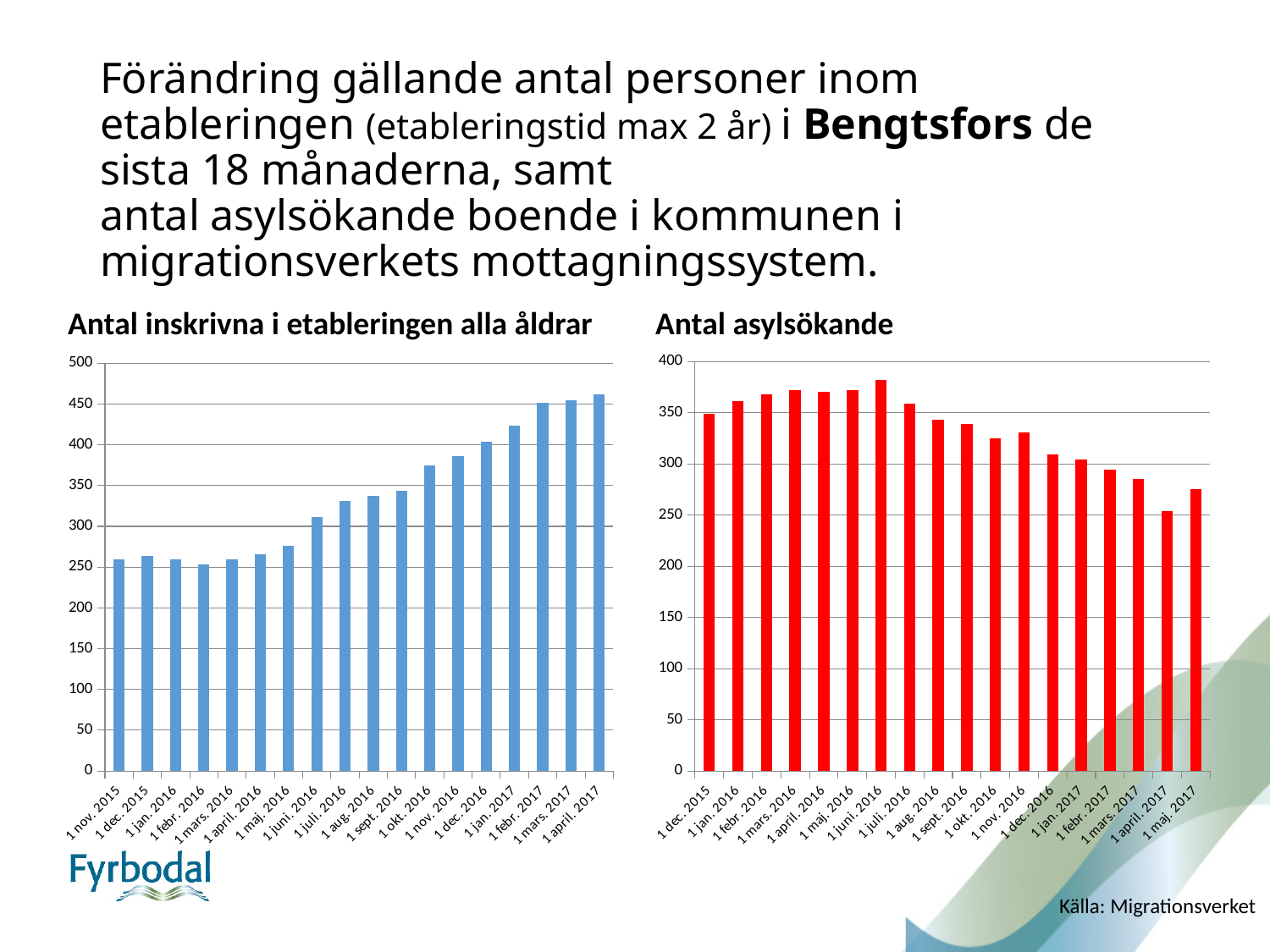
What kind of chart is the 'Antal inskrivna i etableringen alla åldrar' chart? bar chart In the 'Antal asylsökande' chart, do the values generally rise or fall from 1 juni. 2016 to 1 april. 2017? fall What colour are the bars in the 'Antal asylsökande' chart? red In the 'Antal asylsökande' chart, which is larger: the value for 1 juni. 2016 or the value for 1 maj. 2017? 1 juni. 2016 In the 'Antal inskrivna i etableringen alla åldrar' chart, do the values generally rise or fall from left to right? rise In the 'Antal asylsökande' chart, is the value for 1 mars. 2017 greater or less than 300? less In the 'Antal asylsökande' chart, which month has the highest value? 1 juni. 2016 In the 'Antal inskrivna i etableringen alla åldrar' chart, is the value for 1 april. 2017 greater or less than 450? greater How many bars (months) are shown in the 'Antal inskrivna i etableringen alla åldrar' chart? 18 In the 'Antal inskrivna i etableringen alla åldrar' chart, is the value for 1 nov. 2015 greater or less than 300? less In the 'Antal asylsökande' chart, which month has the lowest value? 1 april. 2017 How many bars (months) are shown in the 'Antal asylsökande' chart? 18